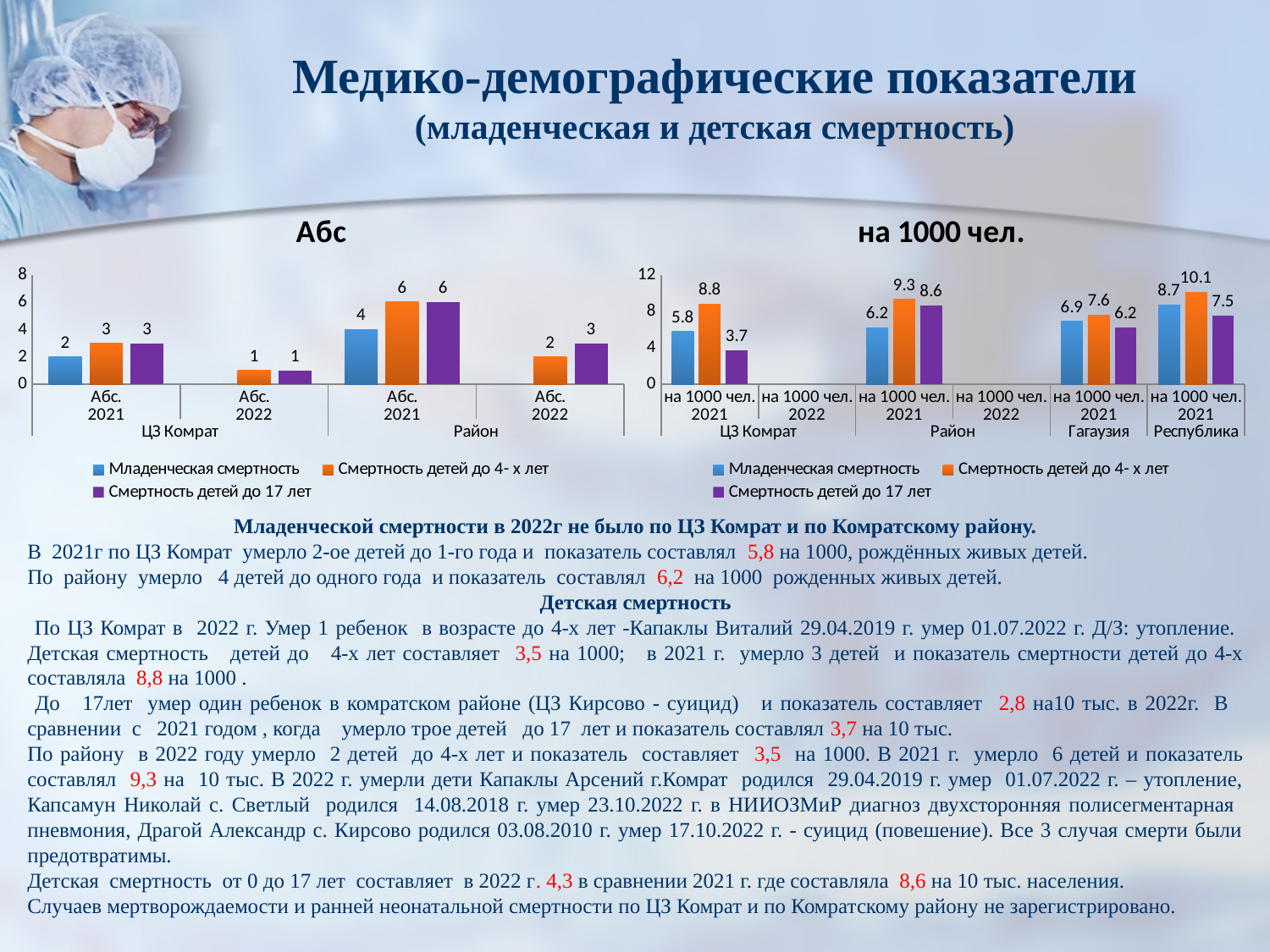
In the chart titled "Абс", how many series does the legend list? 3 In the chart titled "Абс", what is the value of Смертность детей до 17 лет for Район in Абс. 2022? 3 What kind of chart is the chart titled "на 1000 чел."? Bar chart In the chart titled "на 1000 чел.", which group has the highest value of Младенческая смертность? Республика 2021 In the chart titled "на 1000 чел.", what is the value of Смертность детей до 17 лет for ЦЗ Комрат in 2021? 3.7 In the chart titled "Абс", what is the value of Смертность детей до 4-х лет for Район in Абс. 2021? 6 In the chart titled "Абс", what is the difference between Смертность детей до 4-х лет for Район in Абс. 2021 and for Район in Абс. 2022? 4 In the chart titled "на 1000 чел.", what is the difference between Младенческая смертность for Район in 2021 and for ЦЗ Комрат in 2021? 0.4 In the chart titled "на 1000 чел.", what colour are the bars for Смертность детей до 17 лет? Purple In the chart titled "на 1000 чел.", what is the value of Смертность детей до 4-х лет for Республика in 2021? 10.1 In the chart titled "Абс", what is the value of Младенческая смертность for ЦЗ Комрат in Абс. 2021? 2 In the chart titled "на 1000 чел.", which is larger: Смертность детей до 4-х лет for Район in 2021 or for Гагаузия in 2021? Район 2021